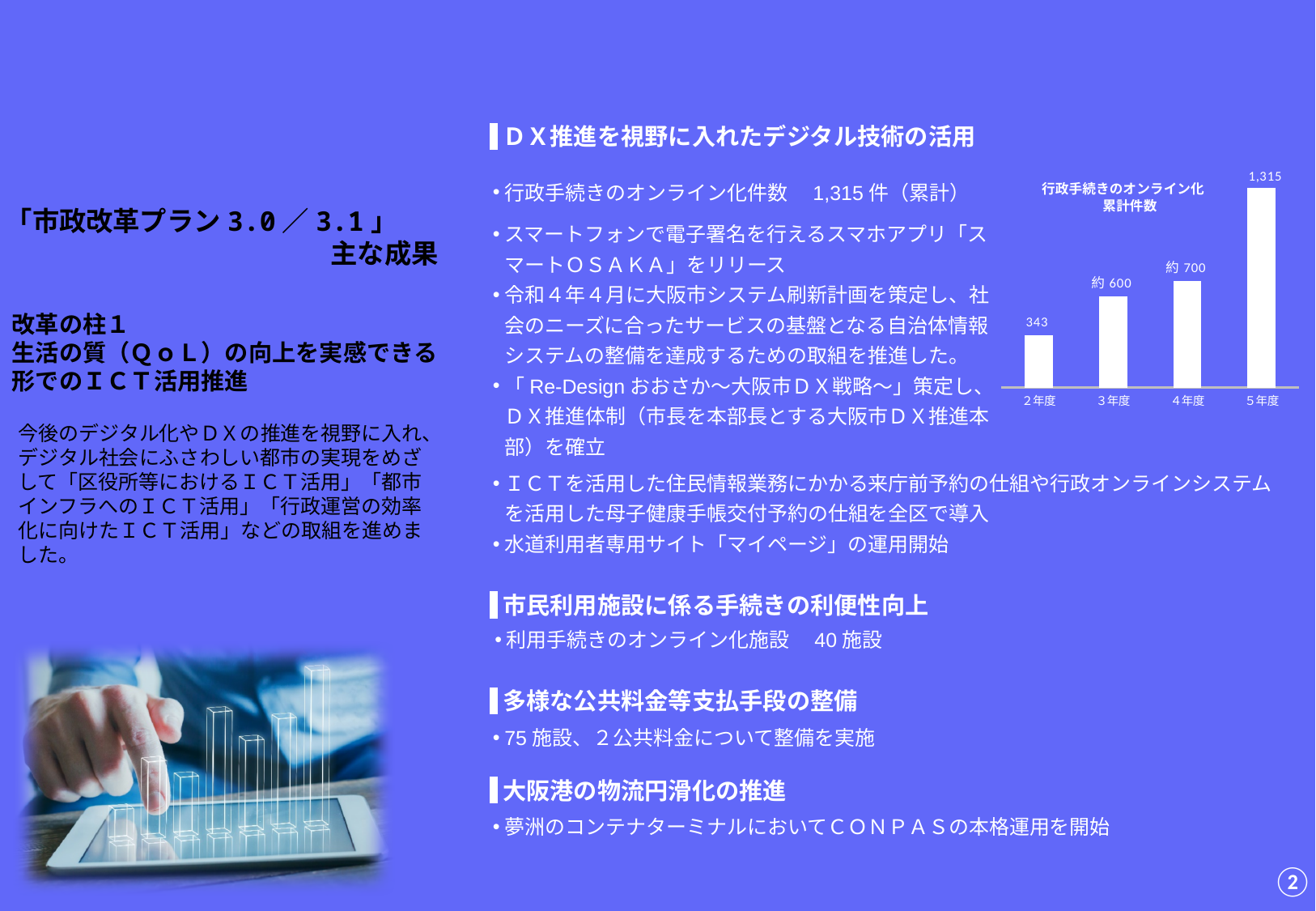
Which year has the lowest value in the 行政手続きのオンライン化累計件数 chart? 2年度 What is the value for 2年度 in the 行政手続きのオンライン化累計件数 chart? 343 What kind of chart is the 行政手続きのオンライン化累計件数 chart? bar chart How many years (categories) are shown in the 行政手続きのオンライン化累計件数 chart? 4 Which year has the highest value in the 行政手続きのオンライン化累計件数 chart? 5年度 What label is shown for 4年度 in the 行政手続きのオンライン化累計件数 chart? 約 700 What is the value for 5年度 in the 行政手続きのオンライン化累計件数 chart? 1,315 What label is shown for 3年度 in the 行政手続きのオンライン化累計件数 chart? 約 600 In the 行政手続きのオンライン化累計件数 chart, which is larger, the value for 3年度 or 4年度? 4年度 What is the title of the chart on the slide? 行政手続きのオンライン化累計件数 Do the values in the 行政手続きのオンライン化累計件数 chart rise or fall from 2年度 to 5年度? rise What is the difference between the values for 5年度 and 2年度 in the 行政手続きのオンライン化累計件数 chart? 972